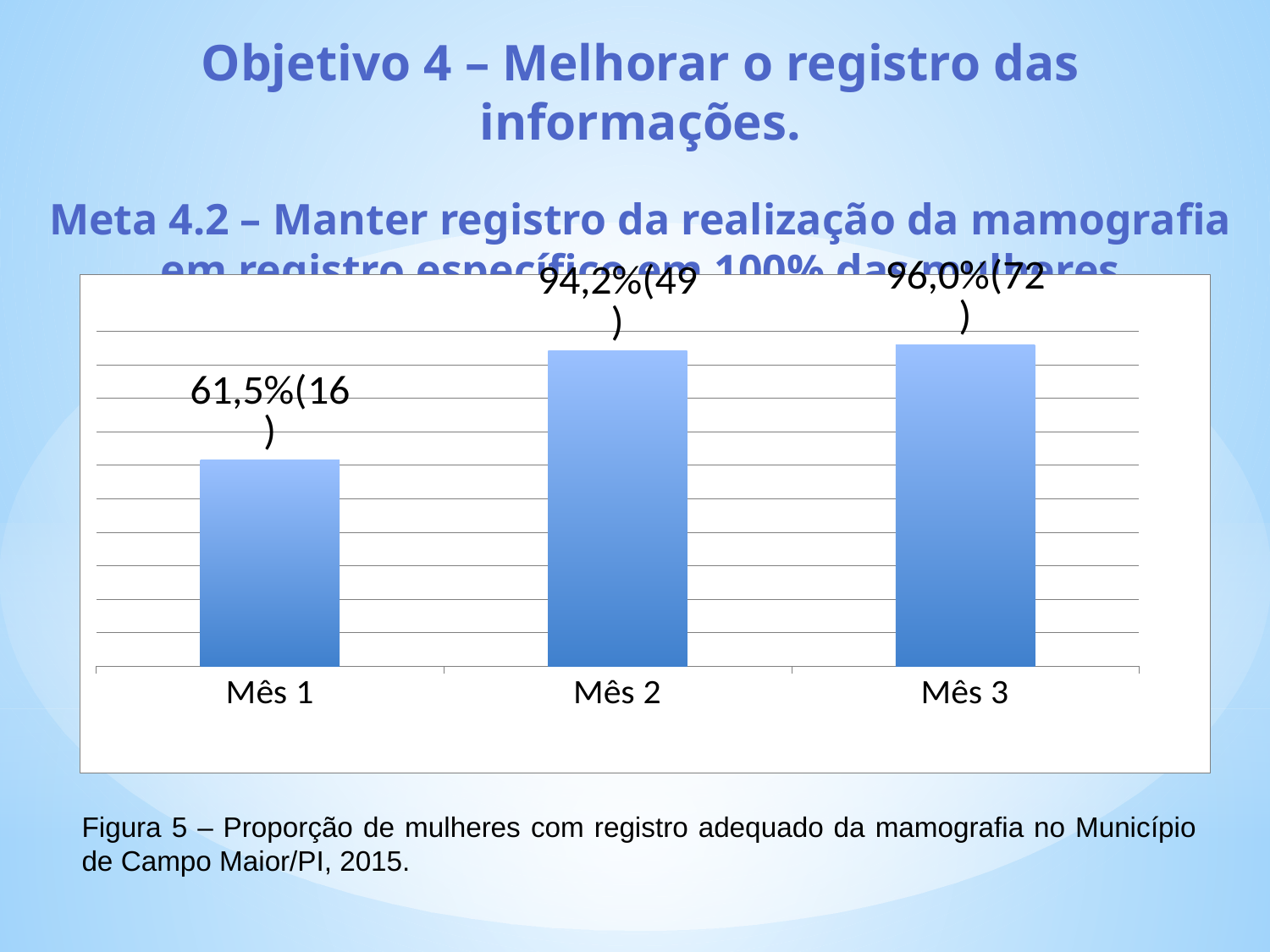
What figure number is given in the caption below the chart? Figura 5 What kind of chart is shown on the slide? Bar chart How many months are shown on the x axis? 3 Which month has the highest proportion? Mês 3 What is the difference in percentage points between Mês 2 and Mês 1? 32,7 What is the difference in percentage points between Mês 3 and Mês 1? 34,5 What is the value shown for Mês 1? 61,5%(16) Do the values rise or fall from Mês 1 to Mês 3? Rise Which month has the lowest proportion? Mês 1 What is the value shown for Mês 3? 96,0%(72) Which is larger, the value for Mês 2 or the value for Mês 3? Mês 3 What is the value shown for Mês 2? 94,2%(49)